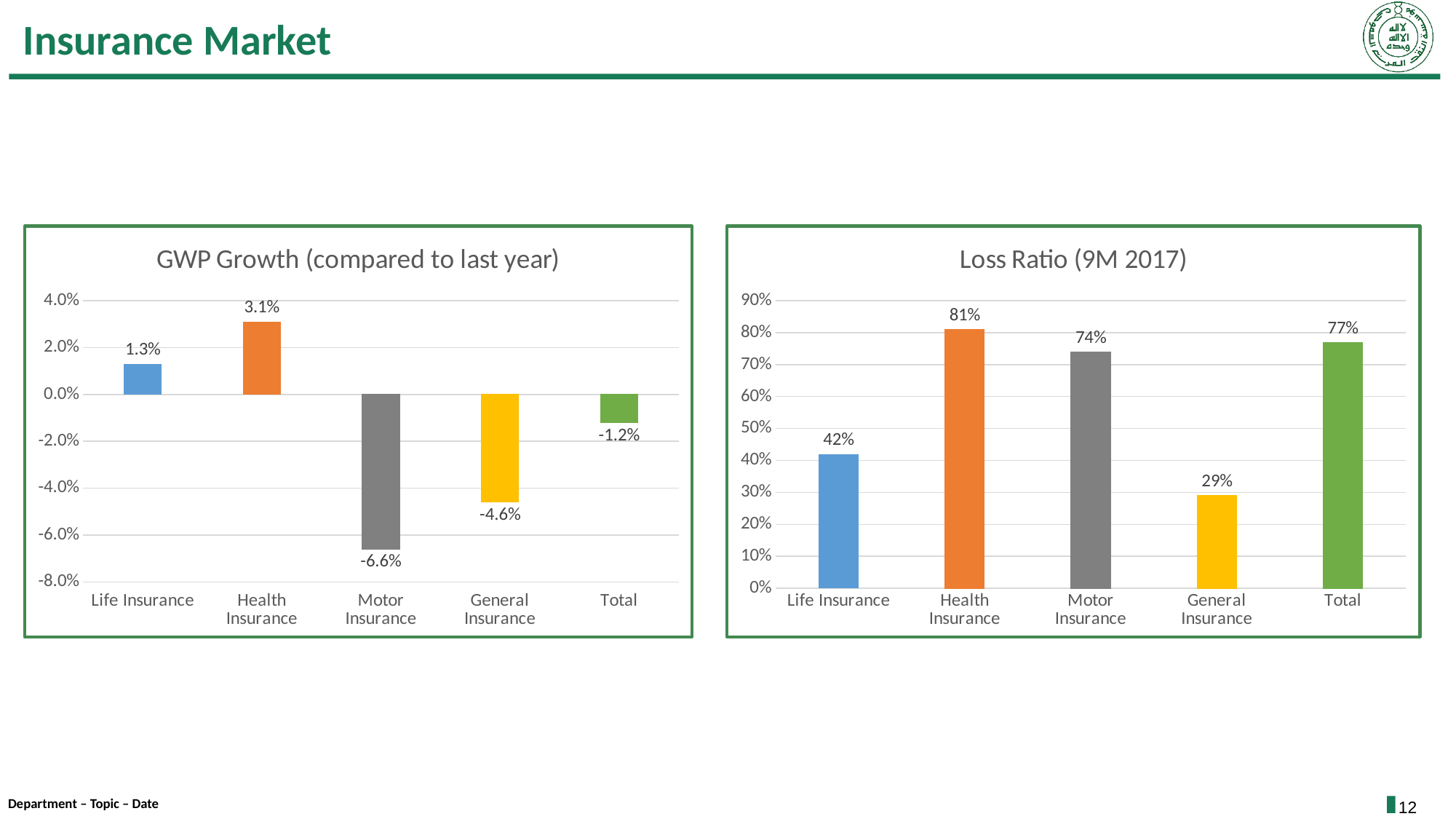
In the Loss Ratio (9M 2017) chart, what is the difference between the Health Insurance and General Insurance values? 52% In the GWP Growth (compared to last year) chart, how many categories are shown? 5 In the Loss Ratio (9M 2017) chart, which category has the highest value? Health Insurance In the Loss Ratio (9M 2017) chart, which is larger, the value for Motor Insurance or the value for Life Insurance? Motor Insurance In the GWP Growth (compared to last year) chart, what is the value for Motor Insurance? -6.6% In the GWP Growth (compared to last year) chart, which category has the lowest value? Motor Insurance In the GWP Growth (compared to last year) chart, what is the value for Health Insurance? 3.1% In the Loss Ratio (9M 2017) chart, what is the value for General Insurance? 29% In the GWP Growth (compared to last year) chart, which category has the highest value? Health Insurance In the Loss Ratio (9M 2017) chart, what is the value for Total? 77% In the GWP Growth (compared to last year) chart, what is the difference between the Health Insurance and Life Insurance values? 1.8% What kind of chart is the Loss Ratio (9M 2017) chart? Bar chart